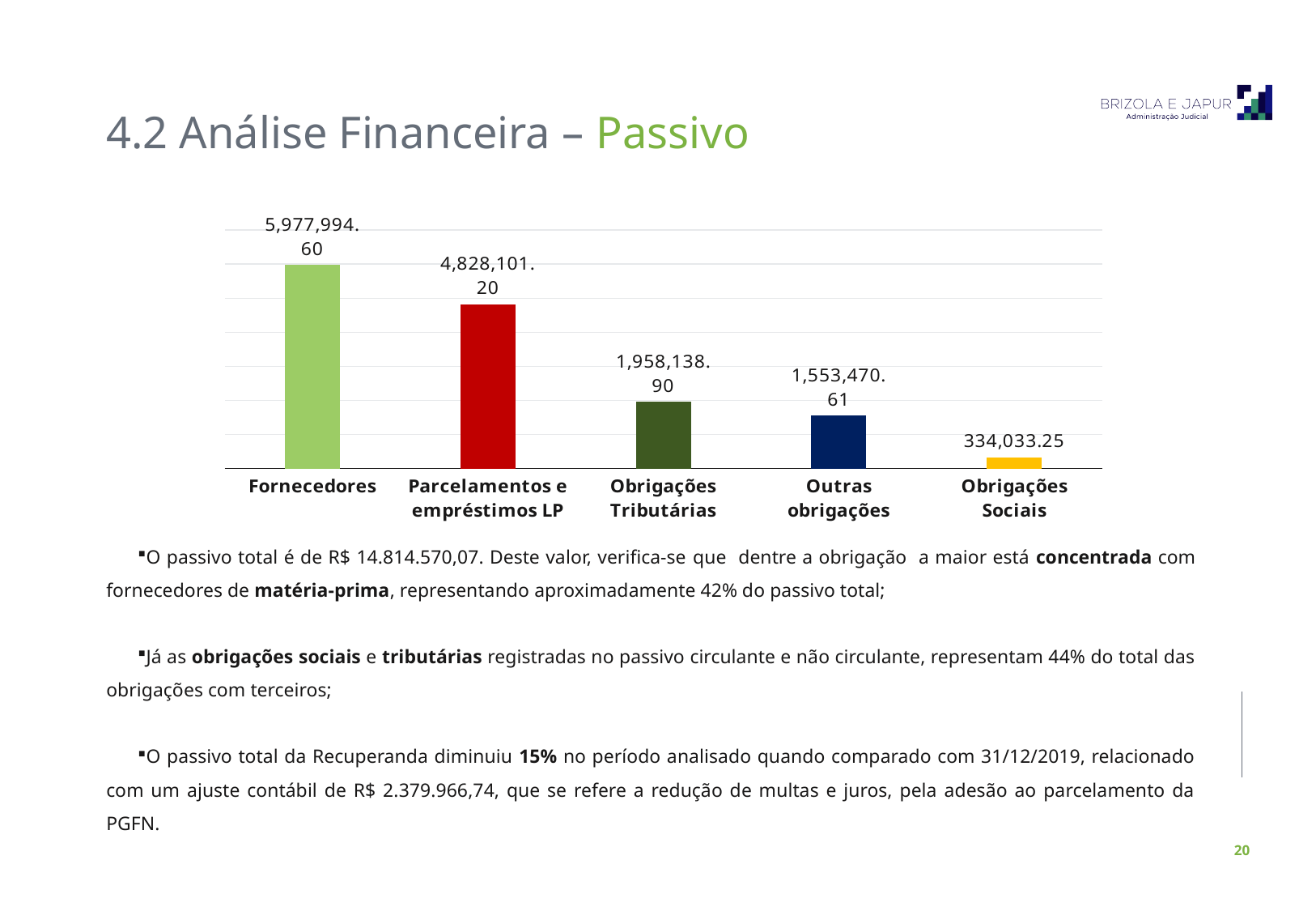
What is the value for Fornecedores? 5,977,994.60 How many categories are shown in the chart? 5 What is the difference between the values for Obrigações Tributárias and Outras obrigações? 404,668.29 Which is larger, the value for Obrigações Tributárias or the value for Outras obrigações? Obrigações Tributárias What is the value for Outras obrigações? 1,553,470.61 What is the value for Obrigações Tributárias? 1,958,138.90 What is the value for Obrigações Sociais? 334,033.25 What is the difference between the values for Fornecedores and Parcelamentos e empréstimos LP? 1,149,893.40 Which category has the lowest value? Obrigações Sociais Which category has the highest value? Fornecedores What kind of chart is shown on the slide? Bar chart What is the value for Parcelamentos e empréstimos LP? 4,828,101.20